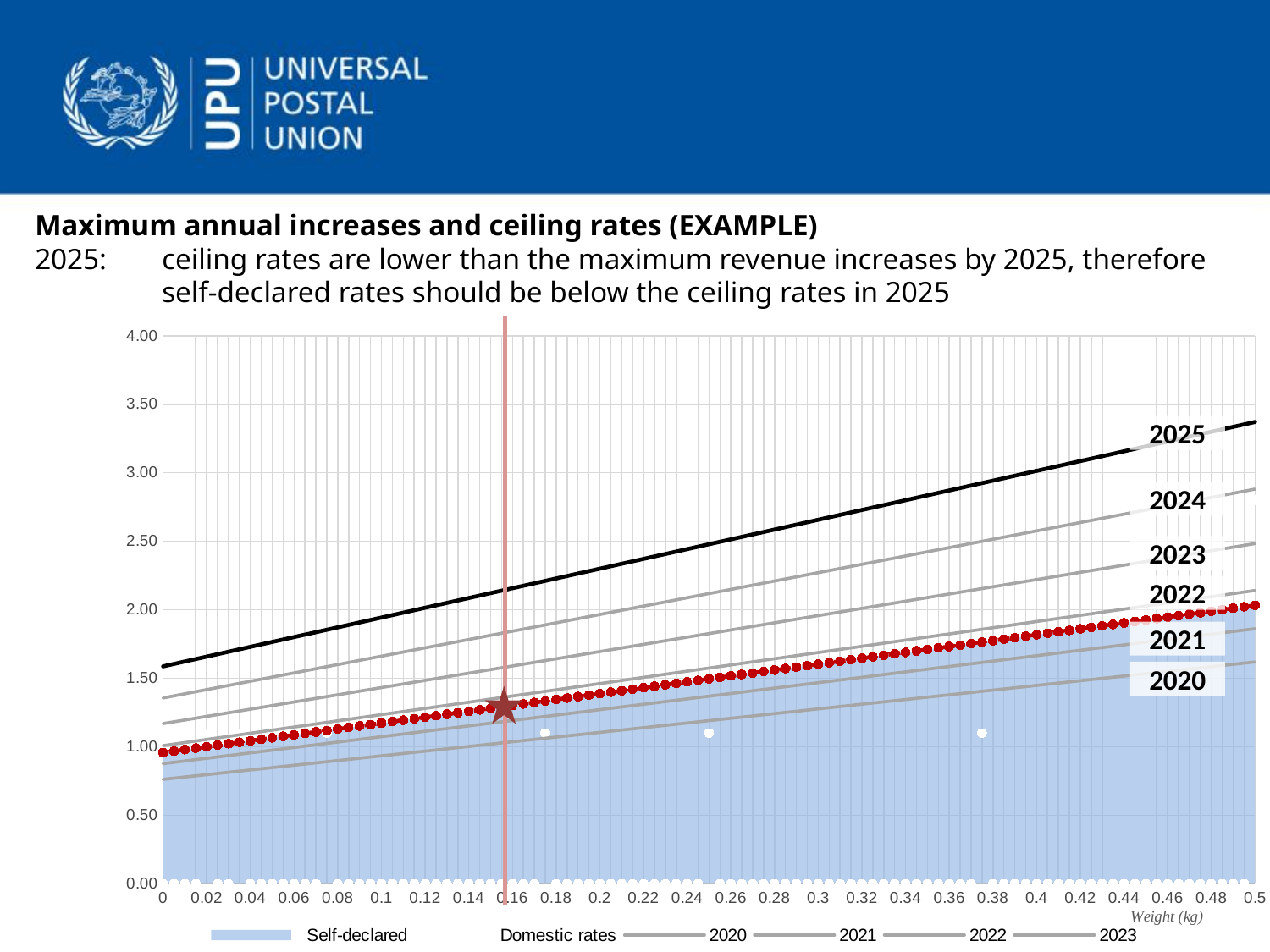
At a weight of 0.5, which is higher: the 2025 line or the 2020 line? 2025 Is the value of the 2020 line at a weight of 0 greater or less than 1.00? less What kind of chart is shown on the slide? combination area and line chart Is the value of the 2025 line at a weight of 0.5 greater or less than 3.00? greater Which year's line is the highest on the chart? 2025 What is the label of the x axis of the chart? Weight (kg) Is the value of the 2020 line at a weight of 0.5 greater or less than 2.00? less What is the highest value shown on the y axis of the chart? 4.00 Do the lines on the chart rise or fall as weight increases? rise Which year's line is the lowest on the chart? 2020 How many entries does the chart legend list? 6